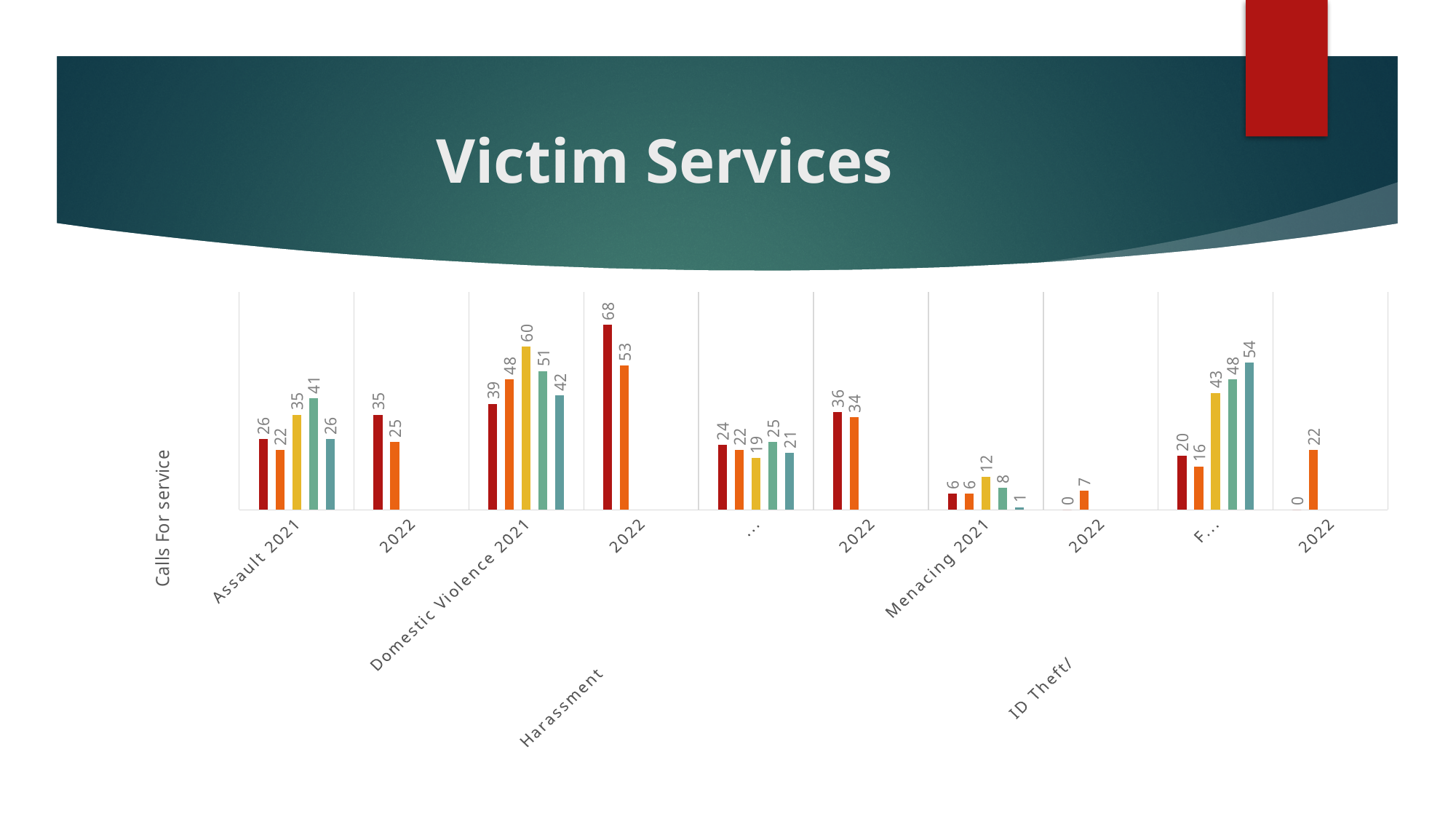
What is the value of the teal (last) bar in the Menacing 2021 group? 1 What is the value of the dark red bar in the Domestic Violence 2022 group? 68 What is the label on the vertical axis of the chart? Calls For service Which is larger: the dark red bar in Assault 2021 or the dark red bar in Assault 2022? Assault 2022 What is the value of the dark red bar in the ID Theft 2022 group? 0 Do the values in the Menacing 2021 group rise or fall from the green bar (8) to the teal bar (1)? fall What type of chart is shown on the slide? bar chart What is the value of the teal (last) bar in the ID Theft/F... 2021 group? 54 What is the value of the orange bar in the Assault 2022 group? 25 What is the difference between the two bars in the Domestic Violence 2022 group (68 and 53)? 15 What is the value of the tallest bar in the Domestic Violence 2021 group? 60 How many bars are in the Assault 2021 group? 5